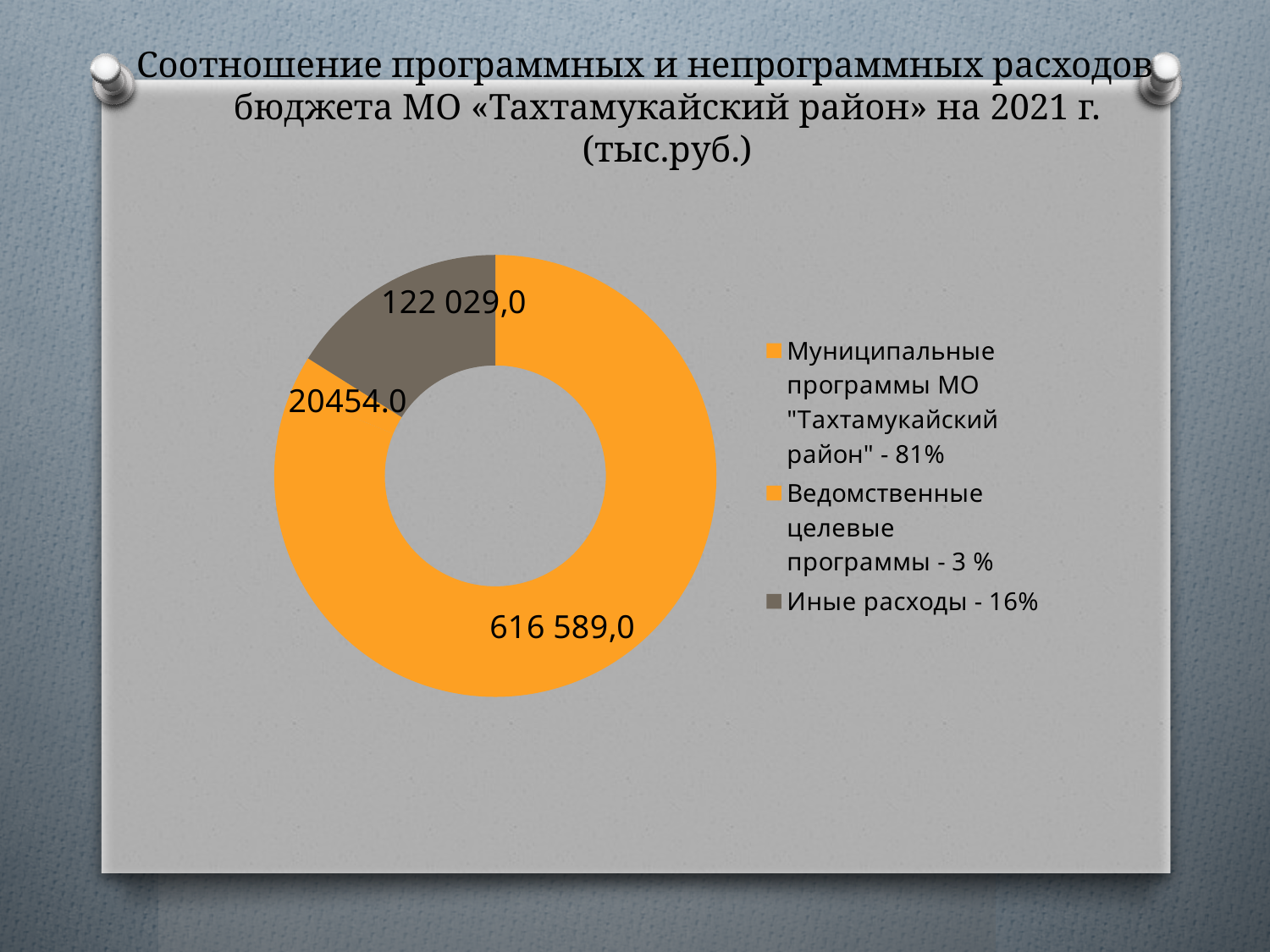
What is the value for Муниципальные программы МО "Тахтамукайский район"? 616 589,0 What is the difference between the value for Муниципальные программы МО "Тахтамукайский район" and the value for Иные расходы? 494 560,0 What unit is stated in the chart title? тыс.руб. What is the value for Ведомственные целевые программы? 20454.0 Which category has the smallest value? Ведомственные целевые программы What share of the total do Иные расходы make up, according to the legend? 16% What is the value for Иные расходы? 122 029,0 Which is larger: the value for Иные расходы or the value for Ведомственные целевые программы? Иные расходы How many categories does the legend list? 3 What type of chart is shown on the slide? Doughnut (pie) chart Which category has the largest value? Муниципальные программы МО "Тахтамукайский район" What share of the total do Муниципальные программы МО "Тахтамукайский район" make up, according to the legend? 81%